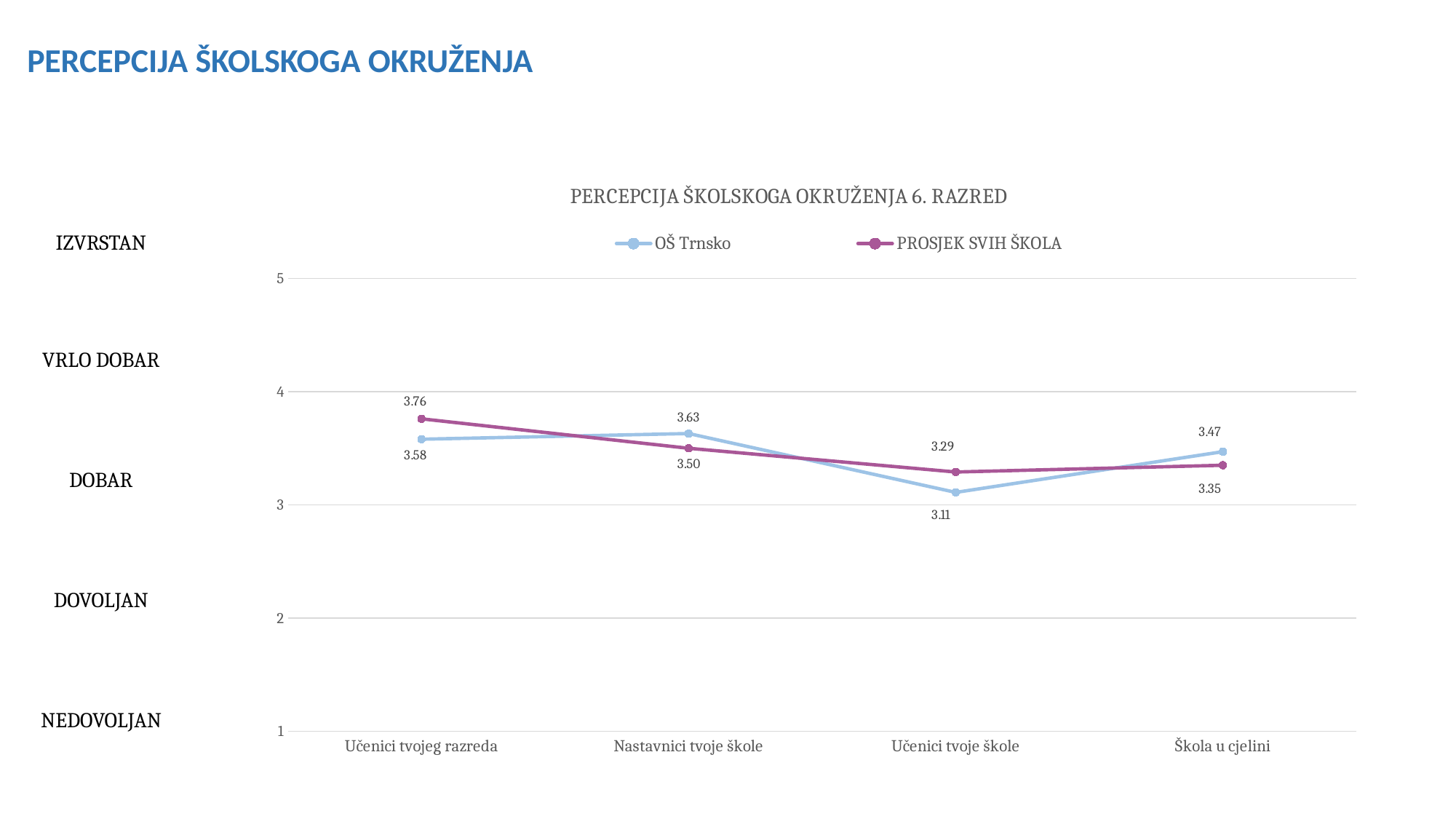
What kind of chart is shown on the slide? Line chart What is the value for OŠ Trnsko at Učenici tvoje škole? 3.11 Which series has the larger value at Nastavnici tvoje škole, OŠ Trnsko or PROSJEK SVIH ŠKOLA? OŠ Trnsko Is the OŠ Trnsko value at Učenici tvoje škole greater or less than 3? greater What is the value for OŠ Trnsko at Učenici tvojeg razreda? 3.58 What is the difference between the PROSJEK SVIH ŠKOLA and OŠ Trnsko values at Učenici tvojeg razreda? 0.18 How many series does the legend list? 2 For which category is the OŠ Trnsko value highest? Nastavnici tvoje škole How many categories are shown on the x axis? 4 What is the value for PROSJEK SVIH ŠKOLA at Škola u cjelini? 3.35 For which category is the PROSJEK SVIH ŠKOLA value lowest? Učenici tvoje škole What is the value for PROSJEK SVIH ŠKOLA at Učenici tvojeg razreda? 3.76